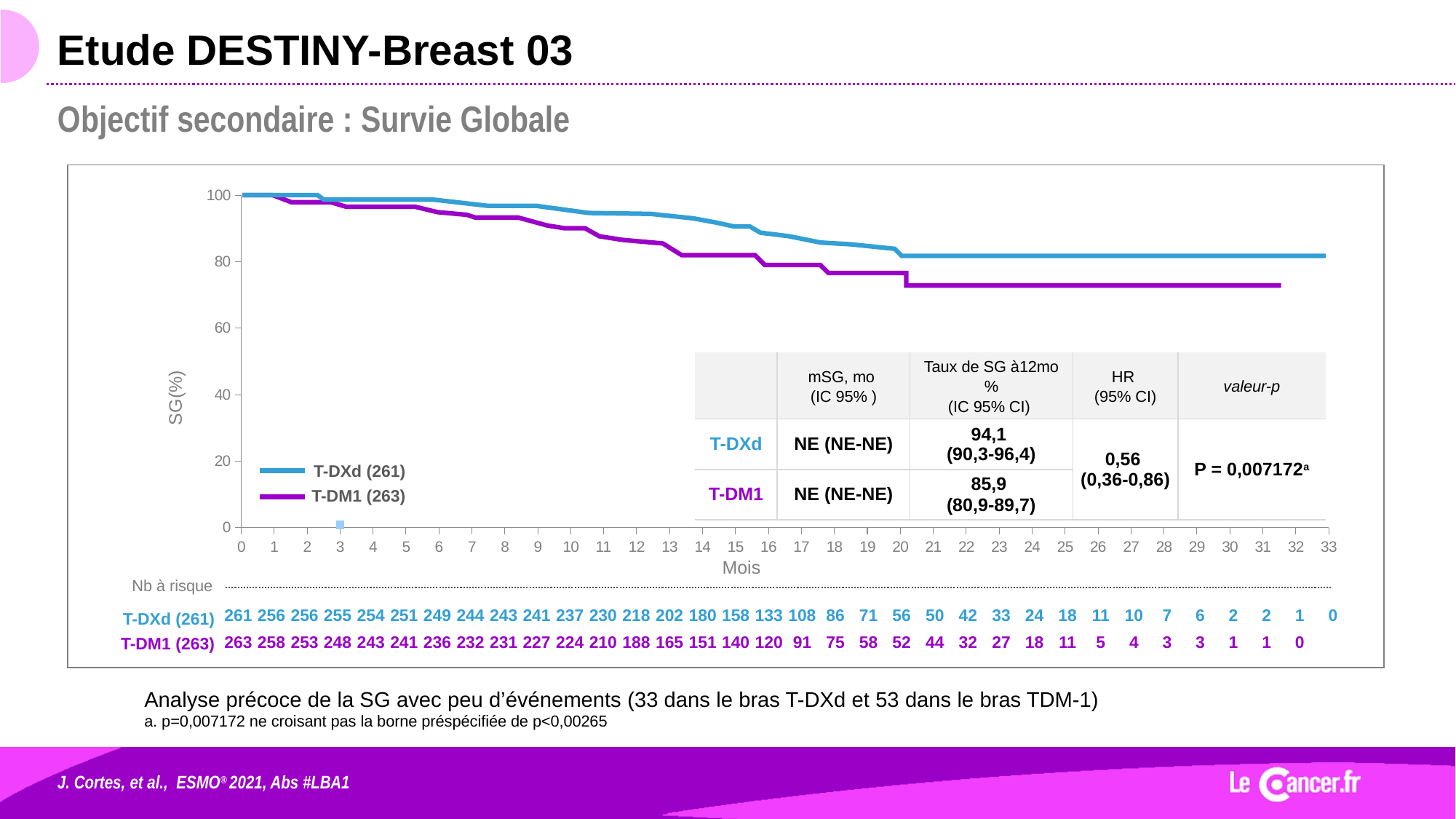
According to the table on the chart, what is the 12-month SG rate for T-DXd? 94,1 What are the two series named in the legend? T-DXd (261) and T-DM1 (263) Do the survival curves rise or fall as the months increase along the x axis? fall Is the value of the T-DXd curve at month 25 greater or less than 80? greater Is the value of the T-DM1 curve at month 25 greater or less than 80? less According to the table on the chart, what is the 12-month SG rate for T-DM1? 85,9 Which curve is higher at month 20, T-DXd or T-DM1? T-DXd What is the difference between the 12-month SG rates of T-DXd and T-DM1 shown in the table? 8,2 What is the number at risk for T-DXd at month 12? 218 How many series does the legend list? 2 What is the label of the x axis? Mois What kind of chart is shown on the slide? line chart